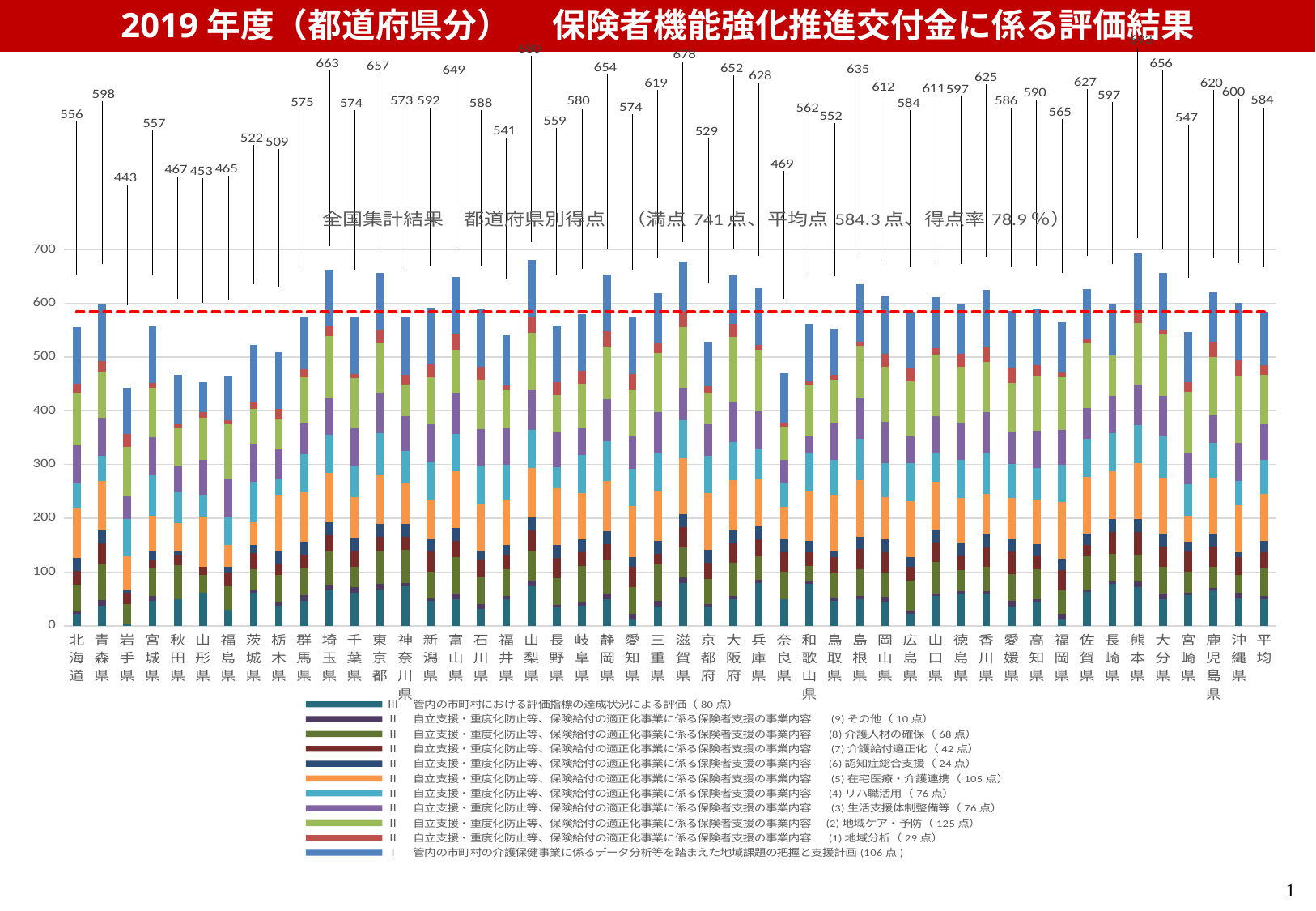
How many series does the legend list? 11 What is the value shown for 平均 (the average bar)? 584 What is the total score shown for 沖縄県? 600 What kind of chart is shown on the slide? Stacked bar chart Which prefecture has the lowest total score? 岩手県 What is the difference between the total scores of 滋賀県 and 岩手県? 235 What is the total score shown for 滋賀県? 678 Is the total score for 奈良県 greater or less than 500? less What is the difference between the total scores of 青森県 and 北海道? 42 Which has the higher total score, 埼玉県 or 東京都? 埼玉県 What is the total score shown for 岩手県? 443 What is the total score shown for 北海道? 556